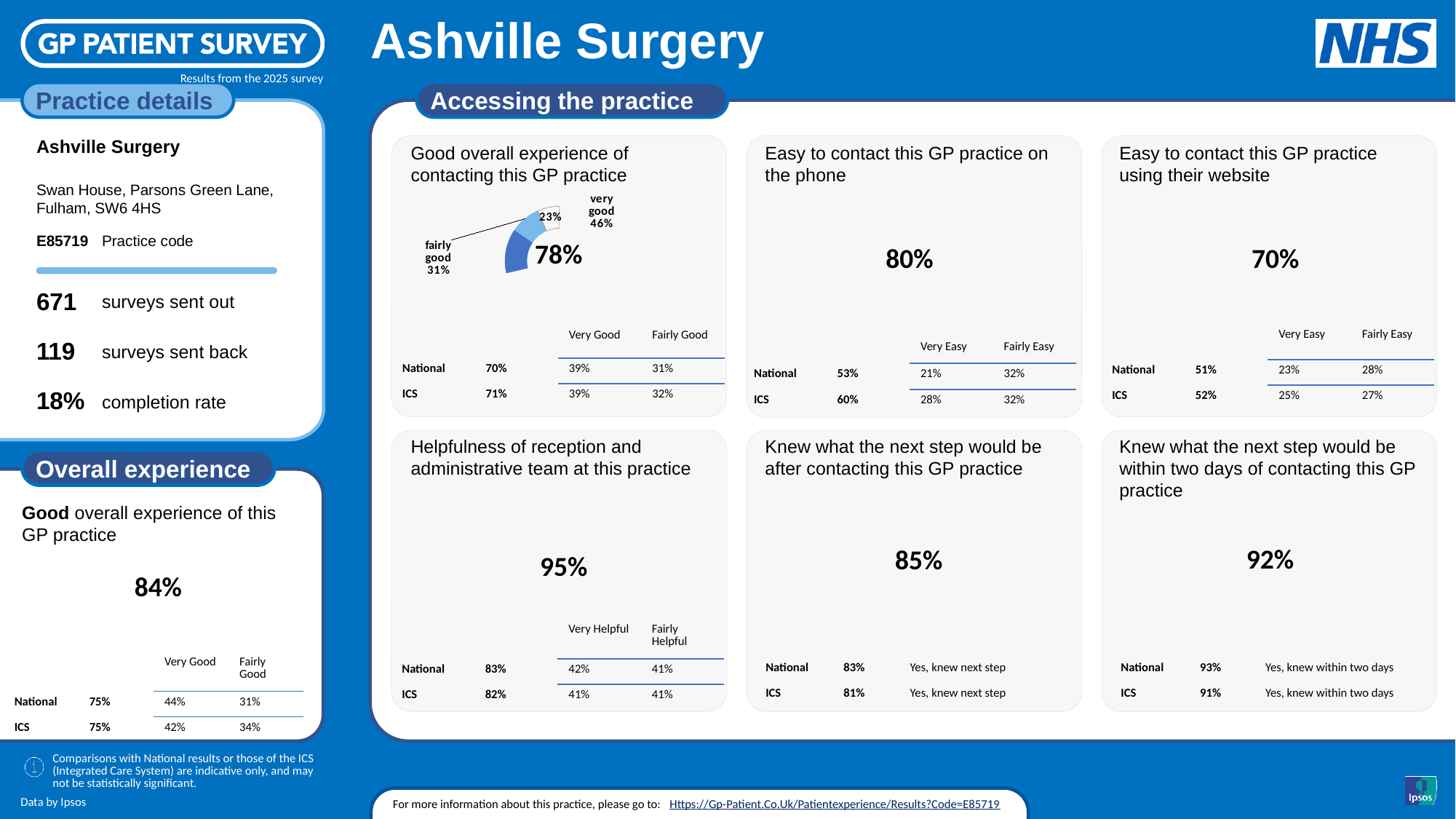
In the 'Good overall experience of contacting this GP practice' chart, what value is printed in the centre of the chart? 78% What kind of chart is used in the 'Good overall experience of contacting this GP practice' panel? doughnut chart In the 'Good overall experience of contacting this GP practice' chart, what is the difference between the 'very good' and 'fairly good' percentages? 15 percentage points In the 'Good overall experience of contacting this GP practice' chart, what percentage is labelled 'very good'? 46% In the 'Good overall experience of contacting this GP practice' chart, which labelled segment is larger, 'very good' or 'fairly good'? very good What is the title of the panel on the slide that contains a chart? Good overall experience of contacting this GP practice In the 'Good overall experience of contacting this GP practice' chart, what share of the chart does 'very good' represent? 46% In the 'Good overall experience of contacting this GP practice' chart, what is the smallest percentage printed on a segment? 23% In the 'Good overall experience of contacting this GP practice' chart, what percentage is labelled 'fairly good'? 31%